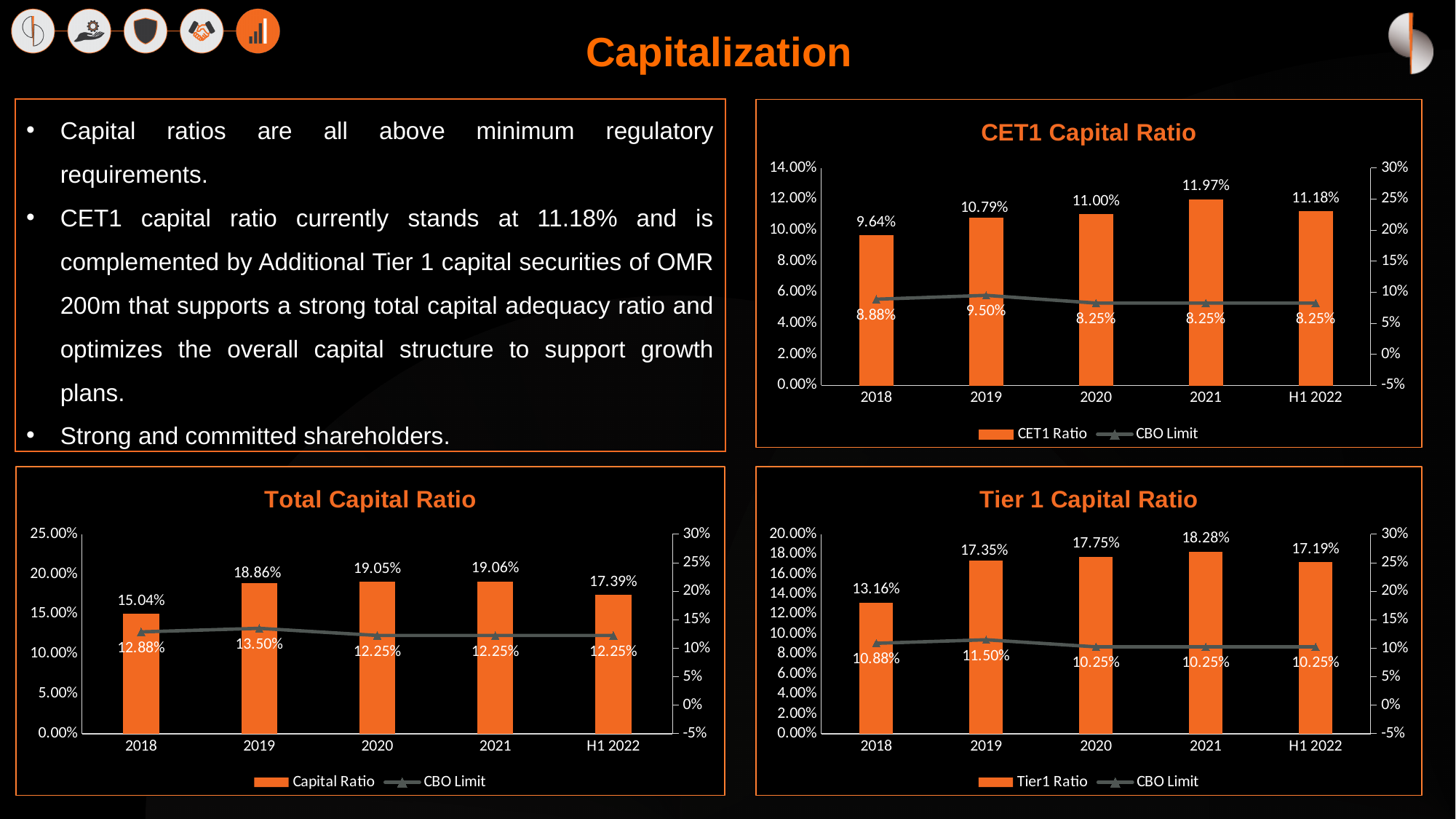
In the CET1 Capital Ratio chart, which year has the lowest CET1 Ratio? 2018 In the Total Capital Ratio chart, how many series does the legend list? 2 In the Tier 1 Capital Ratio chart, is the Tier1 Ratio for 2019 larger or smaller than the Tier1 Ratio for H1 2022? larger In the Total Capital Ratio chart, what is the difference between the Capital Ratio and the CBO Limit in 2018? 2.16% In the Total Capital Ratio chart, what is the Capital Ratio for H1 2022? 17.39% In the Tier 1 Capital Ratio chart, how many periods are shown on the x axis? 5 In the CET1 Capital Ratio chart, what is the CET1 Ratio for 2021? 11.97% In the CET1 Capital Ratio chart, what is the difference between the CET1 Ratio in 2019 and in 2018? 1.15% In the Tier 1 Capital Ratio chart, what is the CBO Limit for 2020? 10.25% In the CET1 Capital Ratio chart, what is the CBO Limit for 2019? 9.50% In the Tier 1 Capital Ratio chart, which year has the highest Tier1 Ratio? 2021 What type of chart is the Total Capital Ratio chart? Combined bar and line chart